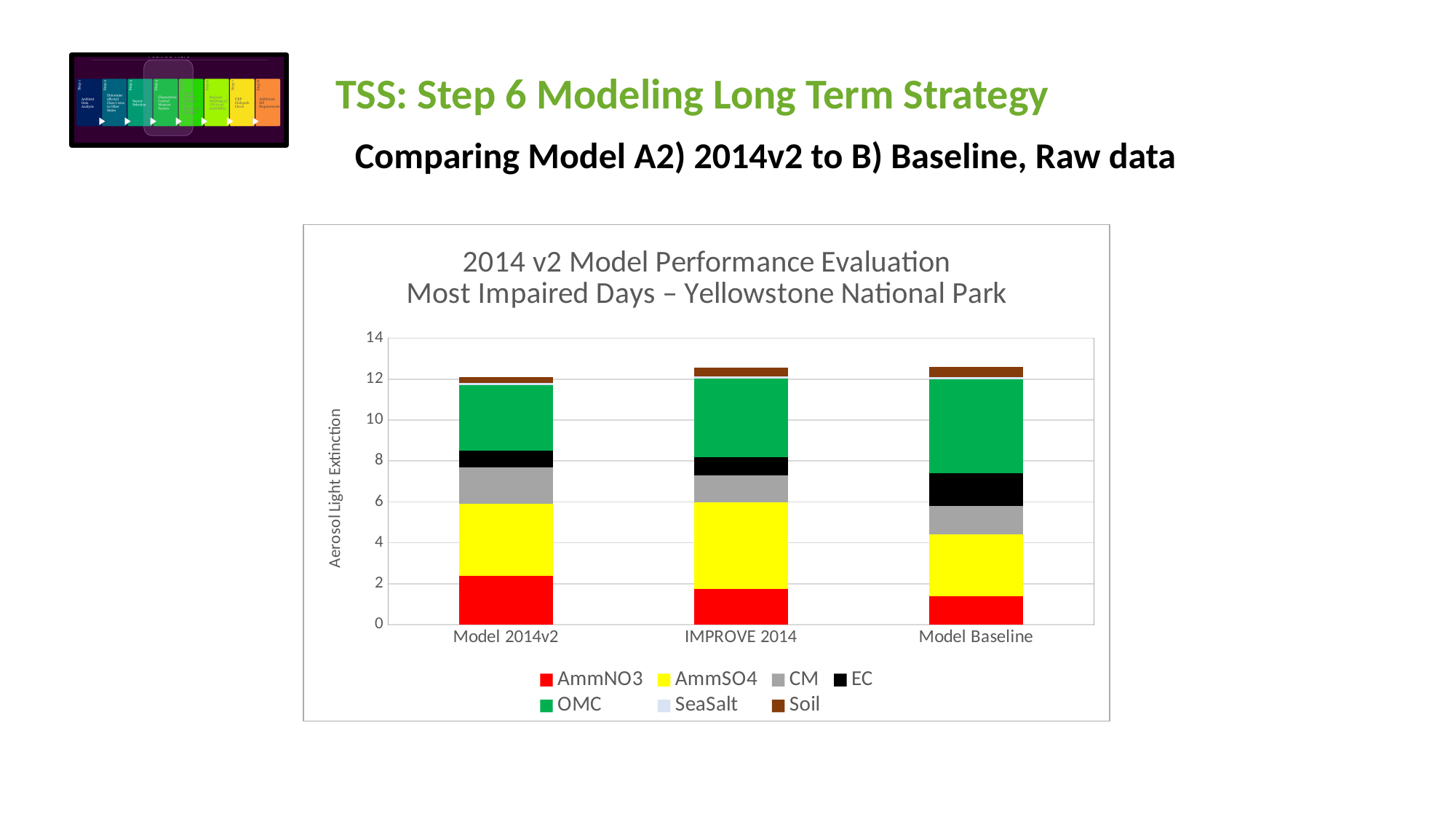
Is the AmmNO3 value for Model Baseline greater or less than 2? less Is the AmmNO3 value for Model 2014v2 greater or less than 2? greater Is the total stacked value for IMPROVE 2014 greater or less than 14? less Which category has the larger AmmNO3 segment, Model 2014v2 or Model Baseline? Model 2014v2 What is the title of the chart? 2014 v2 Model Performance Evaluation Most Impaired Days – Yellowstone National Park What is the label of the y axis? Aerosol Light Extinction Which category has the largest EC segment? Model Baseline How many series does the chart's legend list? 7 What kind of chart is shown on the slide? stacked bar chart Which category has the larger OMC segment, Model 2014v2 or Model Baseline? Model Baseline How many categories are shown on the x axis of the chart? 3